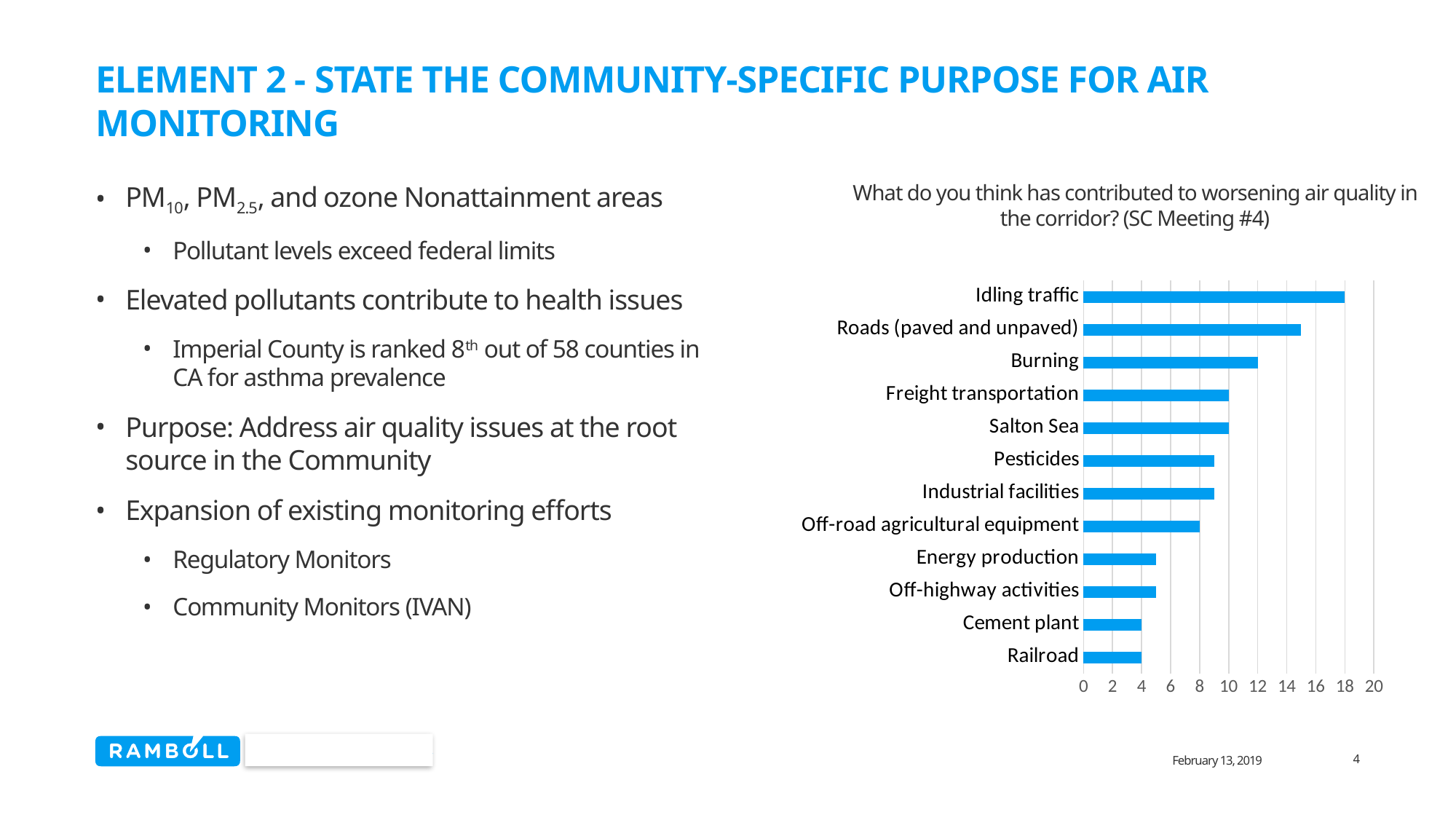
What kind of chart is shown on the slide? Bar chart Which category has the highest value in the chart? Idling traffic Which is larger, the value for Idling traffic or the value for Burning? Idling traffic Which is larger, the value for Off-road agricultural equipment or the value for Cement plant? Off-road agricultural equipment Is the value for Pesticides greater or less than 10? less What is the value for Burning? 12 What is the title of the chart? What do you think has contributed to worsening air quality in the corridor? (SC Meeting #4) Is the value for Roads (paved and unpaved) greater or less than 14? greater What is the value for Freight transportation? 10 What is the value for Idling traffic? 18 How many categories are plotted in the chart? 12 Is the value for Energy production greater or less than 6? less